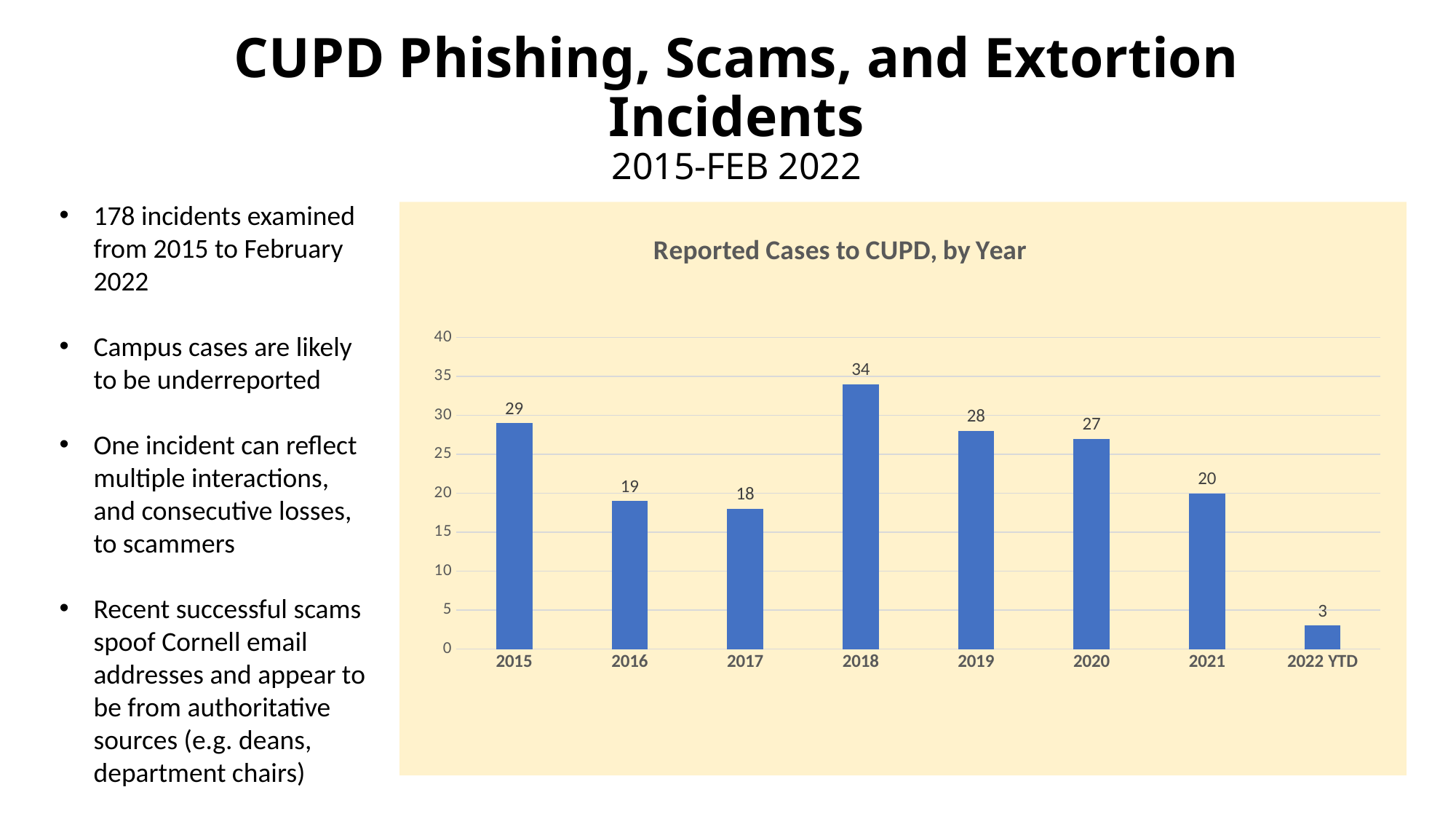
What kind of chart is shown on the slide? bar chart What is the value for 2018 in the Reported Cases to CUPD, by Year chart? 34 What is the title of the chart? Reported Cases to CUPD, by Year Which category has the lowest value in the chart? 2022 YTD How many categories are shown on the x axis of the chart? 8 How many reported cases are shown for 2022 YTD? 3 Do the values rise or fall from 2019 to 2022 YTD? fall Which is larger, the value for 2015 or the value for 2021? 2015 What is the difference between the values for 2018 and 2017? 16 Is the value for 2019 greater or less than 25? greater What is the value for 2016? 19 Which year has the highest number of reported cases? 2018